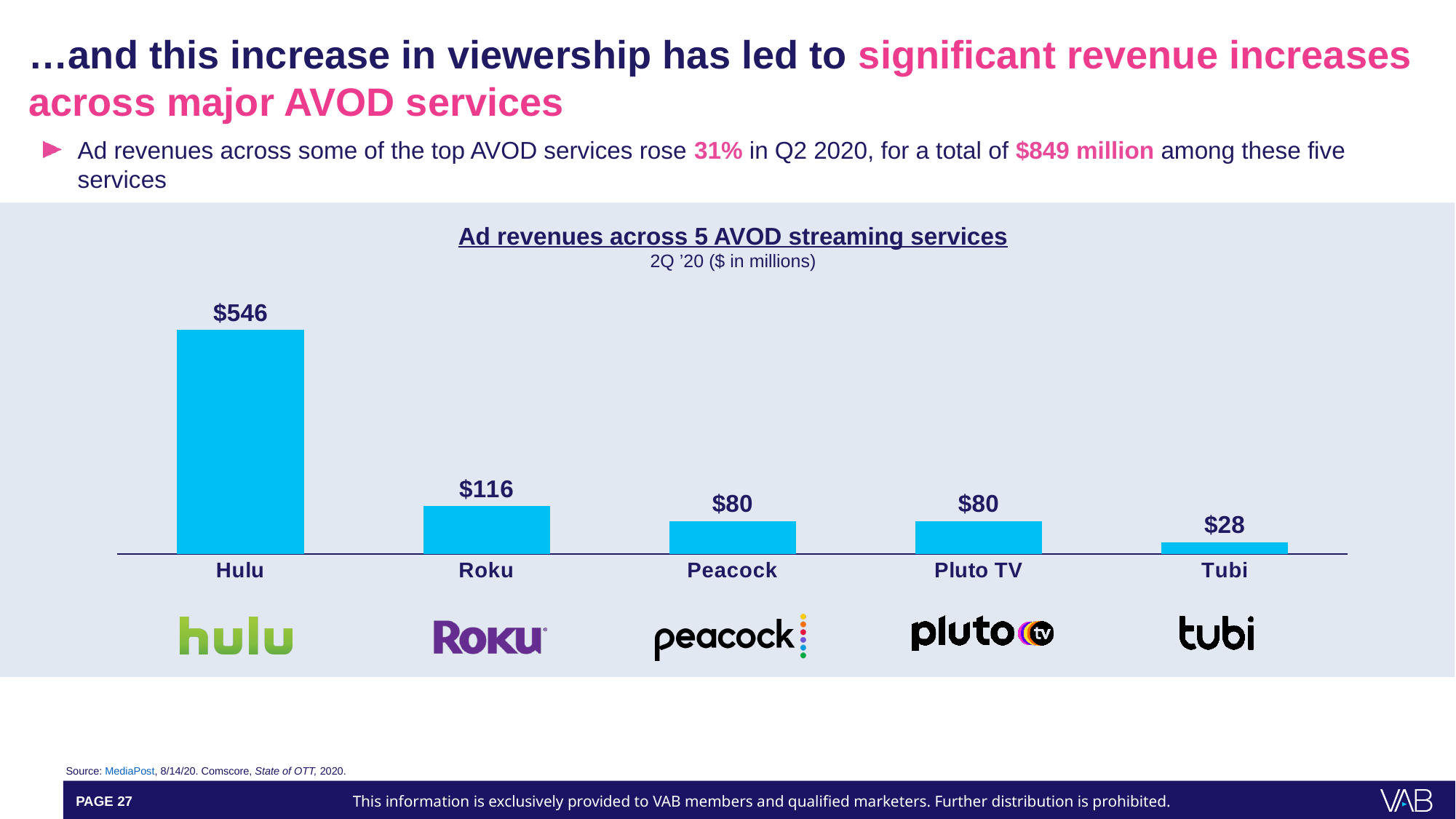
What is the title of the chart? Ad revenues across 5 AVOD streaming services What type of chart is shown on the slide? Bar chart What is the difference between Hulu's and Roku's ad revenue values? $430 What is the ad revenue value shown for Tubi? $28 What is the ad revenue value shown for Hulu? $546 Which service has the highest ad revenue in the chart? Hulu Which has a larger ad revenue value, Roku or Peacock? Roku How many services are shown in the chart? 5 What is the ad revenue value shown for Peacock? $80 What is the ad revenue value shown for Roku? $116 Which service has the lowest ad revenue in the chart? Tubi What is the difference between Pluto TV's and Tubi's ad revenue values? $52